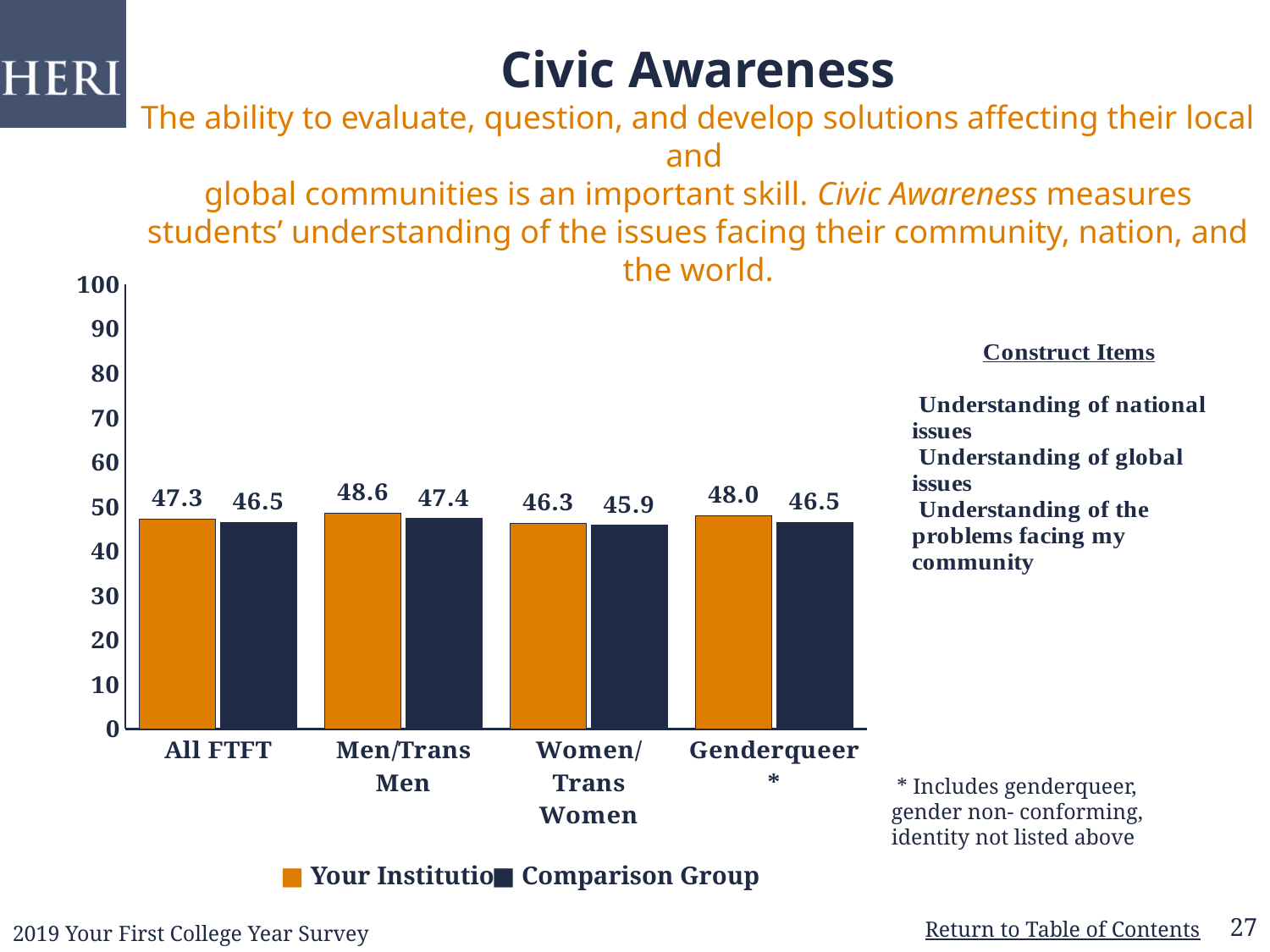
Which category has the highest Your Institution value? Men/Trans Men What is the Your Institution value for Genderqueer*? 48.0 What is the Your Institution value for All FTFT? 47.3 Which category has the lowest Comparison Group value? Women/Trans Women What kind of chart is shown on the slide? Bar chart Which is larger for Men/Trans Men: Your Institution or Comparison Group? Your Institution How many series does the legend list? 2 What is the Comparison Group value for Men/Trans Men? 47.4 What is the title of the slide? Civic Awareness How many categories are shown on the x axis? 4 What is the Comparison Group value for Women/Trans Women? 45.9 What is the difference between the Your Institution and Comparison Group values for Genderqueer*? 1.5